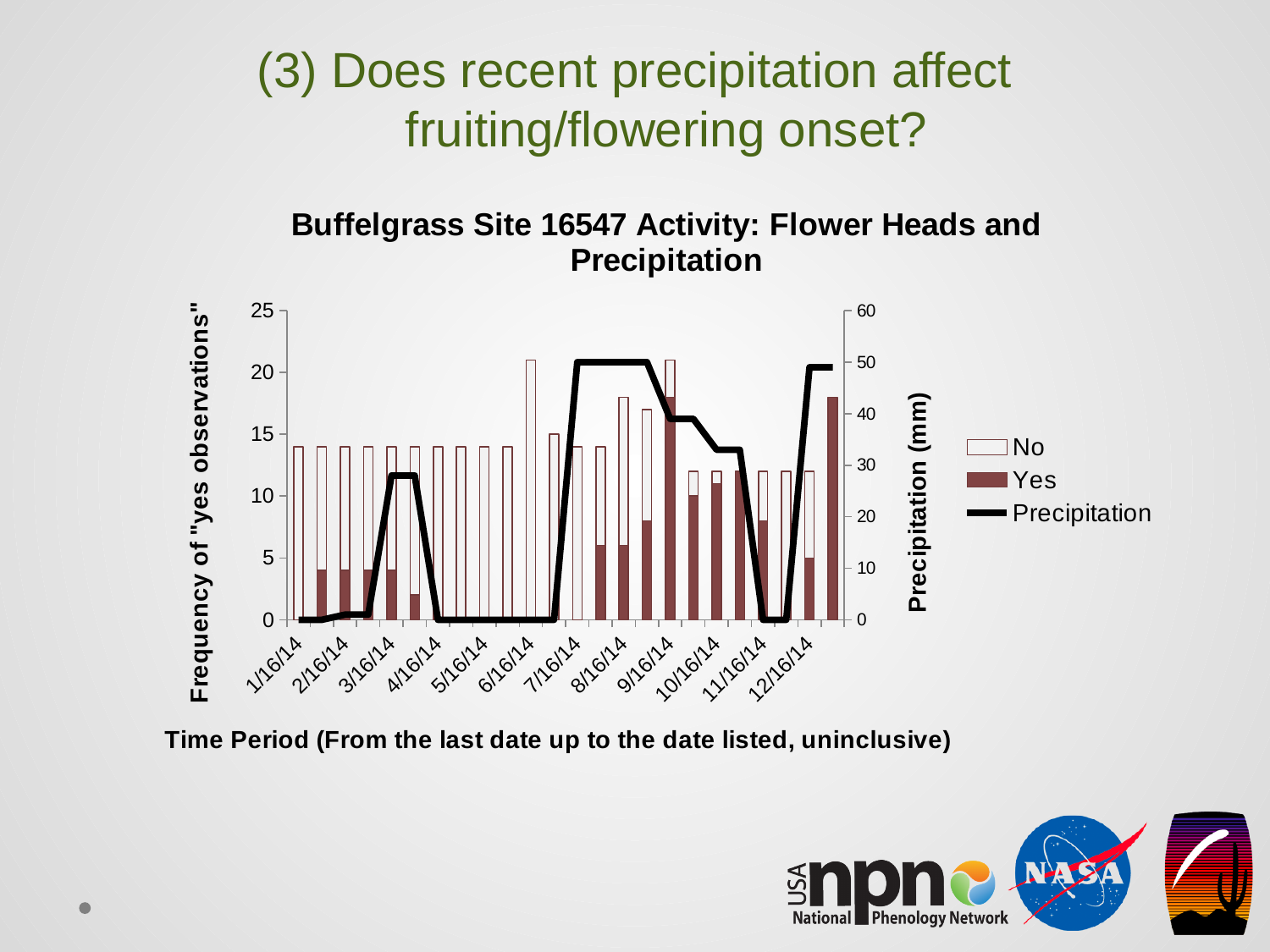
Which is larger, the 'Yes' bar at 12/16/14 or the 'Yes' bar at 2/16/14? 12/16/14 How many series does the legend list? 3 Does the precipitation line rise or fall between 9/16/14 and 11/16/14? fall Is the precipitation value around 7/16/14 greater or less than 40 mm? greater Is the precipitation value around 3/16/14 greater or less than 20 mm? greater Is the 'No' bar at 6/16/14 greater or less than 15? greater What kind of chart is shown on the slide? A bar chart combined with a line What is the title of the chart? Buffelgrass Site 16547 Activity: Flower Heads and Precipitation What is the title of the right-hand vertical axis? Precipitation (mm)